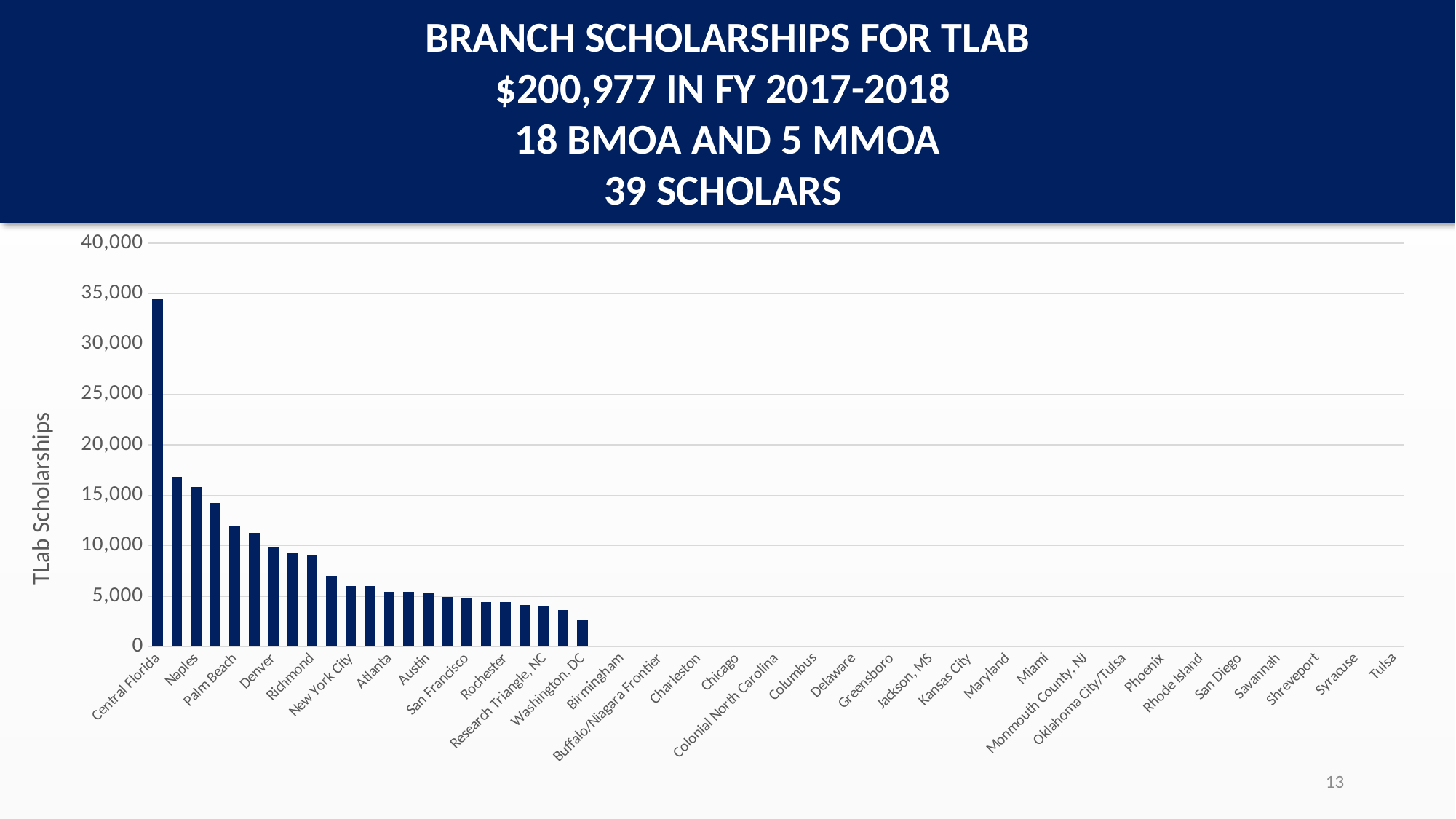
What is the highest value shown on the vertical axis? 40,000 Which is larger, the value for Central Florida or the value for Naples? Central Florida Is the value for Washington, DC greater or less than 5,000? less Is the value for Central Florida greater or less than 30,000? greater What is the label on the vertical axis? TLab Scholarships Do the bar values rise or fall moving from left to right along the x axis? fall Is the value for Naples greater or less than 20,000? less Which branch has the highest TLab scholarship value? Central Florida What kind of chart is shown on the slide? bar chart